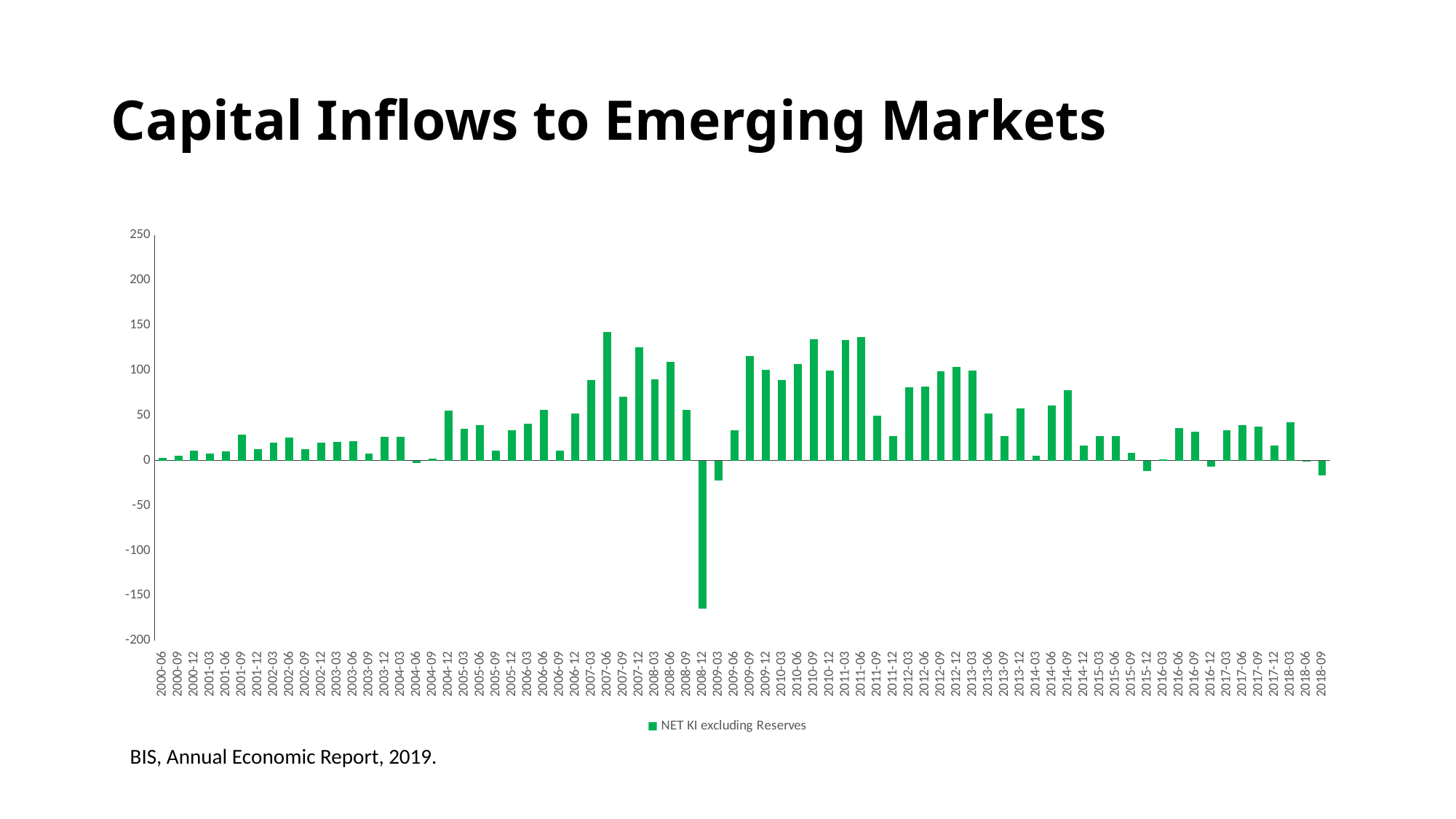
Is the value for 2001-09 greater or less than 50? less Is the value for 2018-09 greater or less than 0? less What kind of chart is shown on the slide? bar chart Is the value for 2008-12 greater or less than -150? less Which is larger, the value for 2007-06 or the value for 2008-09? 2007-06 Which is larger, the value for 2012-12 or the value for 2013-09? 2012-12 How many series does the legend list? 1 Which period has the lowest value? 2008-12 What is the name of the series shown in the legend? NET KI excluding Reserves